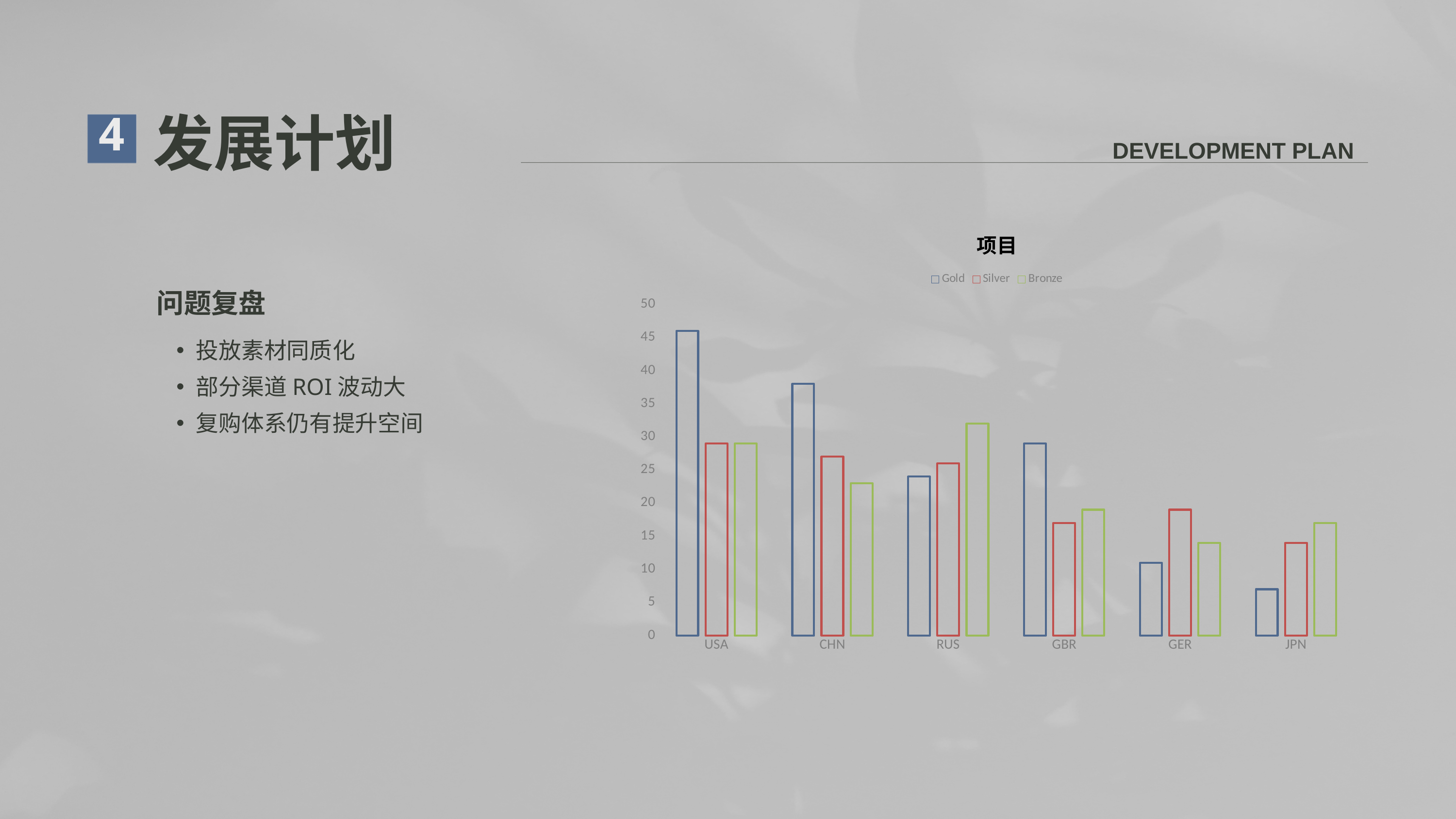
What kind of chart is shown on the slide? bar chart Is the Gold value for USA greater or less than 40? greater Which series are listed in the chart's legend? Gold, Silver, Bronze Which category has the highest Bronze value? RUS How many series does the chart's legend list? 3 Is the Gold value for JPN greater or less than 10? less Which category has the highest Gold value? USA Which is larger, the Silver value for GER or the Gold value for GER? Silver How many categories are shown on the x axis of the chart? 6 Which is larger, the Gold value for CHN or the Gold value for RUS? CHN What is the title of the chart? 项目 Which category has the lowest Gold value? JPN